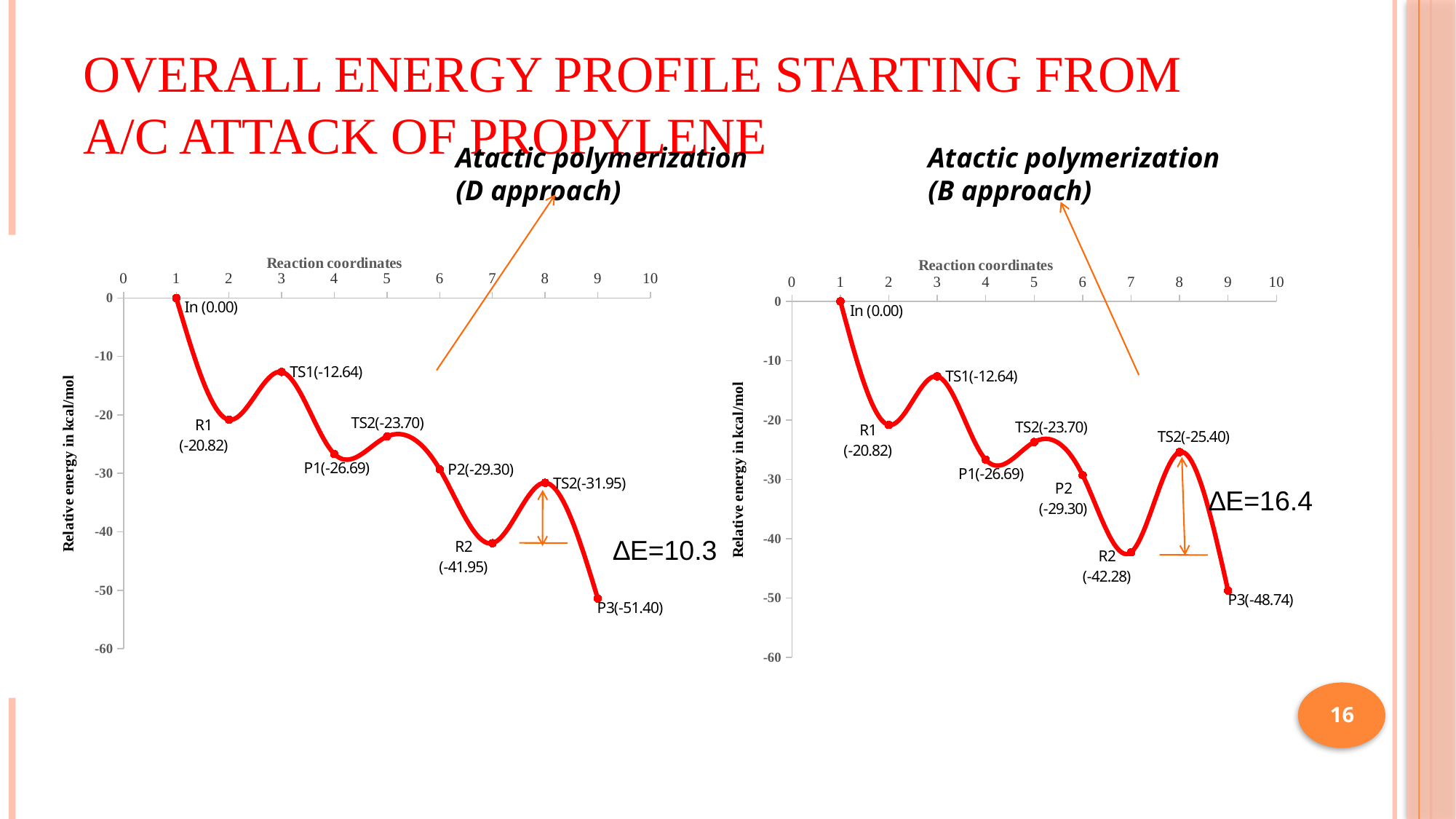
In the Atactic polymerization (B approach) chart, what is the relative energy labelled for R2? -42.28 In the Atactic polymerization (D approach) chart, what is the relative energy labelled for TS1? -12.64 In the Atactic polymerization (D approach) chart, which labelled point has the lowest relative energy? P3 In the Atactic polymerization (B approach) chart, is the relative energy of P1 greater or less than -20? less In the Atactic polymerization (D approach) chart, what is the difference in relative energy between R2 (-41.95) and the TS2 at reaction coordinate 8 (-31.95)? 10.00 In the Atactic polymerization (B approach) chart, what is the relative energy labelled for P3? -48.74 What kind of chart is the Atactic polymerization (B approach) chart? line chart What is the y-axis title of the Atactic polymerization (D approach) chart? Relative energy in kcal/mol In the Atactic polymerization (D approach) chart, what is the relative energy labelled for P3? -51.40 In the Atactic polymerization (B approach) chart, which labelled point has the highest relative energy? In How many labelled data points are plotted in the Atactic polymerization (D approach) chart? 9 Which chart shows a lower relative energy for P3, the D approach chart or the B approach chart? D approach